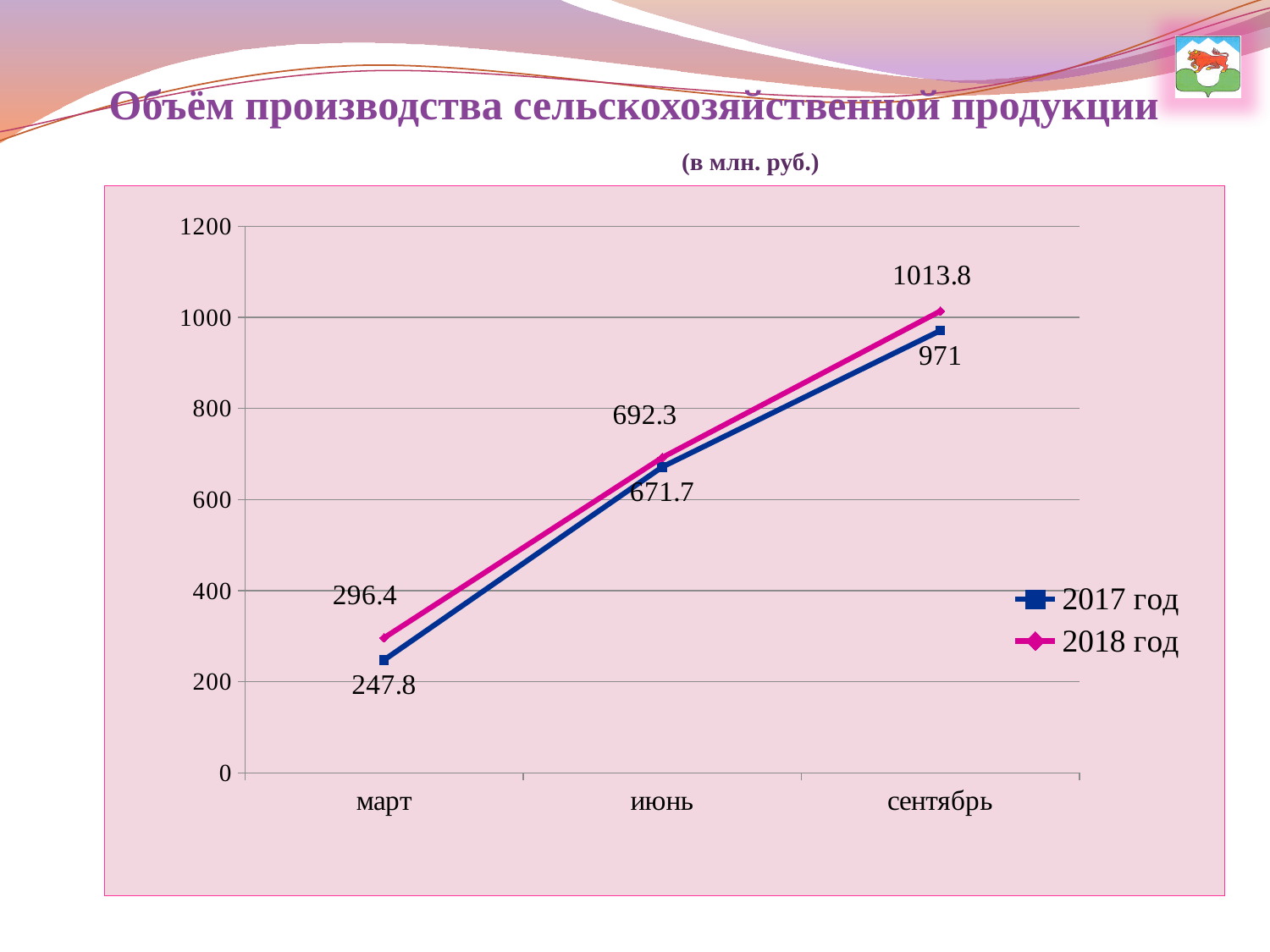
What is the value for 2018 год in сентябрь? 1013.8 What is the value for 2017 год in март? 247.8 Do the values for 2017 год rise or fall from март to сентябрь? rise How many series does the legend list? 2 In which month is the value for 2018 год highest? сентябрь What kind of chart is shown on the slide? line chart How many months are shown on the x axis? 3 What is the value for 2018 год in март? 296.4 What is the difference between the 2018 год and 2017 год values in сентябрь? 42.8 In which month is the value for 2017 год lowest? март What is the value for 2017 год in июнь? 671.7 Which is larger in июнь: the value for 2017 год or for 2018 год? 2018 год